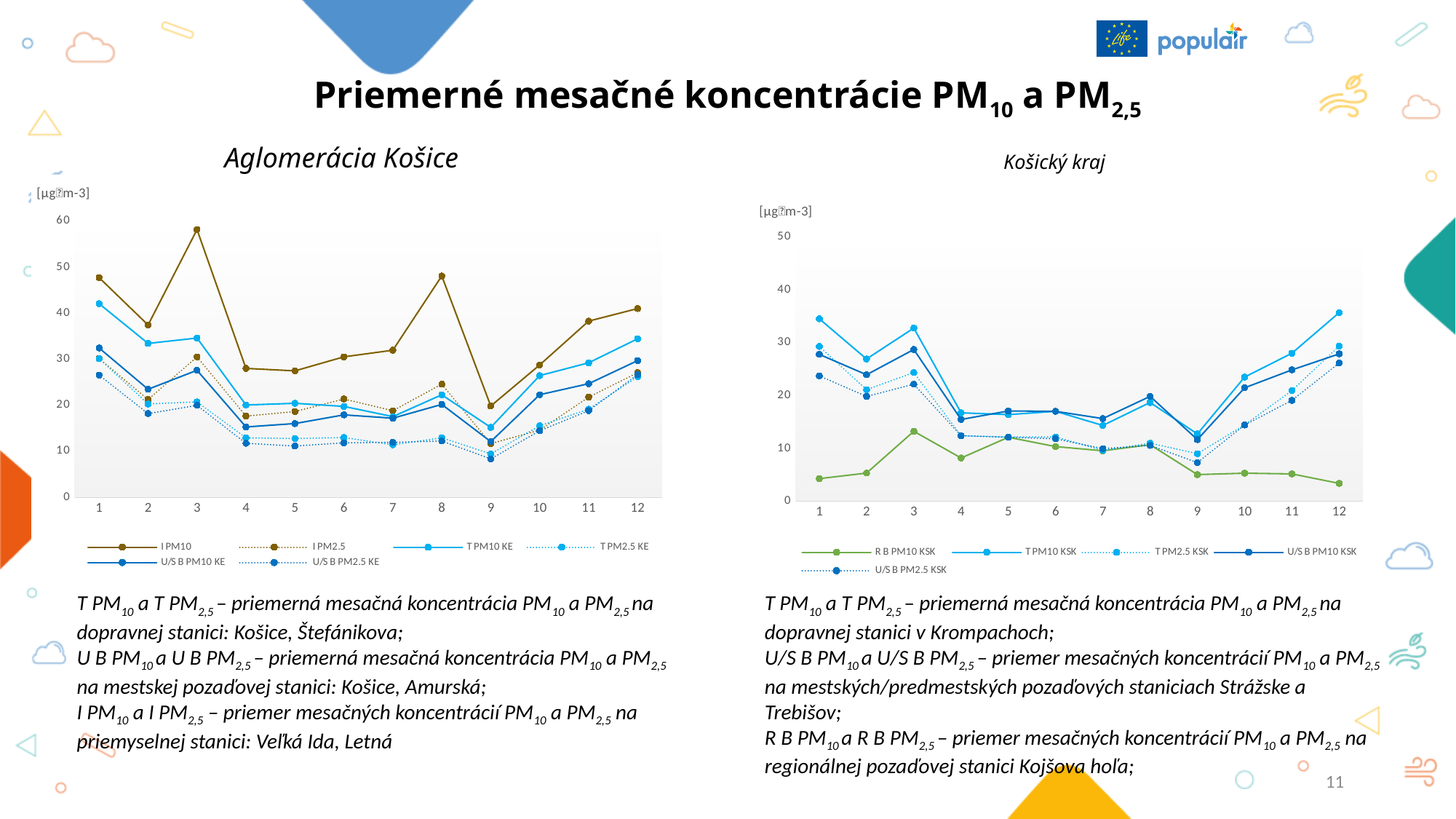
How many series does the legend of the Košický kraj chart list? 5 How many months (x-axis points) are plotted on the Košický kraj chart? 12 On the Košický kraj chart, in which month does the R B PM10 KSK series reach its highest value? 3 What kind of chart is the Aglomerácia Košice chart on the left? line chart On the Aglomerácia Košice chart, is the I PM10 value in month 3 greater or less than 50? greater How many series does the legend of the Aglomerácia Košice chart list? 6 On the Aglomerácia Košice chart, is the U/S B PM2.5 KE value in month 9 greater or less than 10? less On the Košický kraj chart, does the R B PM10 KSK series rise or fall from month 9 to month 12? fall On the Košický kraj chart, is the T PM10 KSK value in month 12 greater or less than 30? greater On the Aglomerácia Košice chart, in which month does the I PM10 series reach its highest value? 3 What unit is shown on the vertical axis of the Košický kraj chart? [µg·m-3] On the Aglomerácia Košice chart, in which month is the I PM10 series lowest? 9